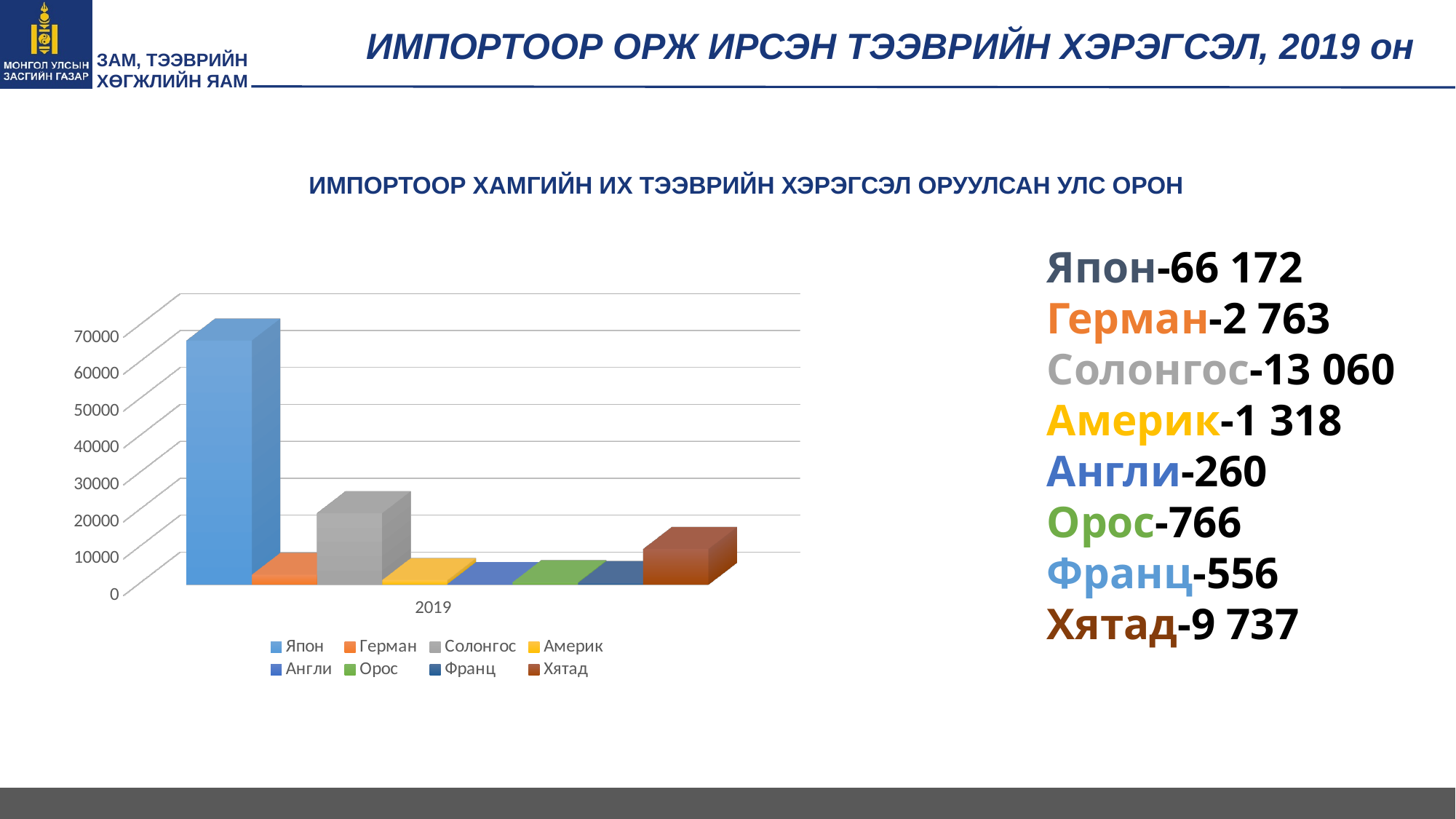
How many series does the chart legend list? 8 Which is larger, the value for Герман or the value for Америк? Герман What is the value for Япон? 66 172 What kind of chart is shown on the slide? bar chart Which country has the lowest value in the chart? Англи Is the value for Япон greater or less than 60000? greater Which country has the highest value in the chart? Япон What year is shown on the x axis of the chart? 2019 What is the value for Хятад? 9 737 What is the value for Англи? 260